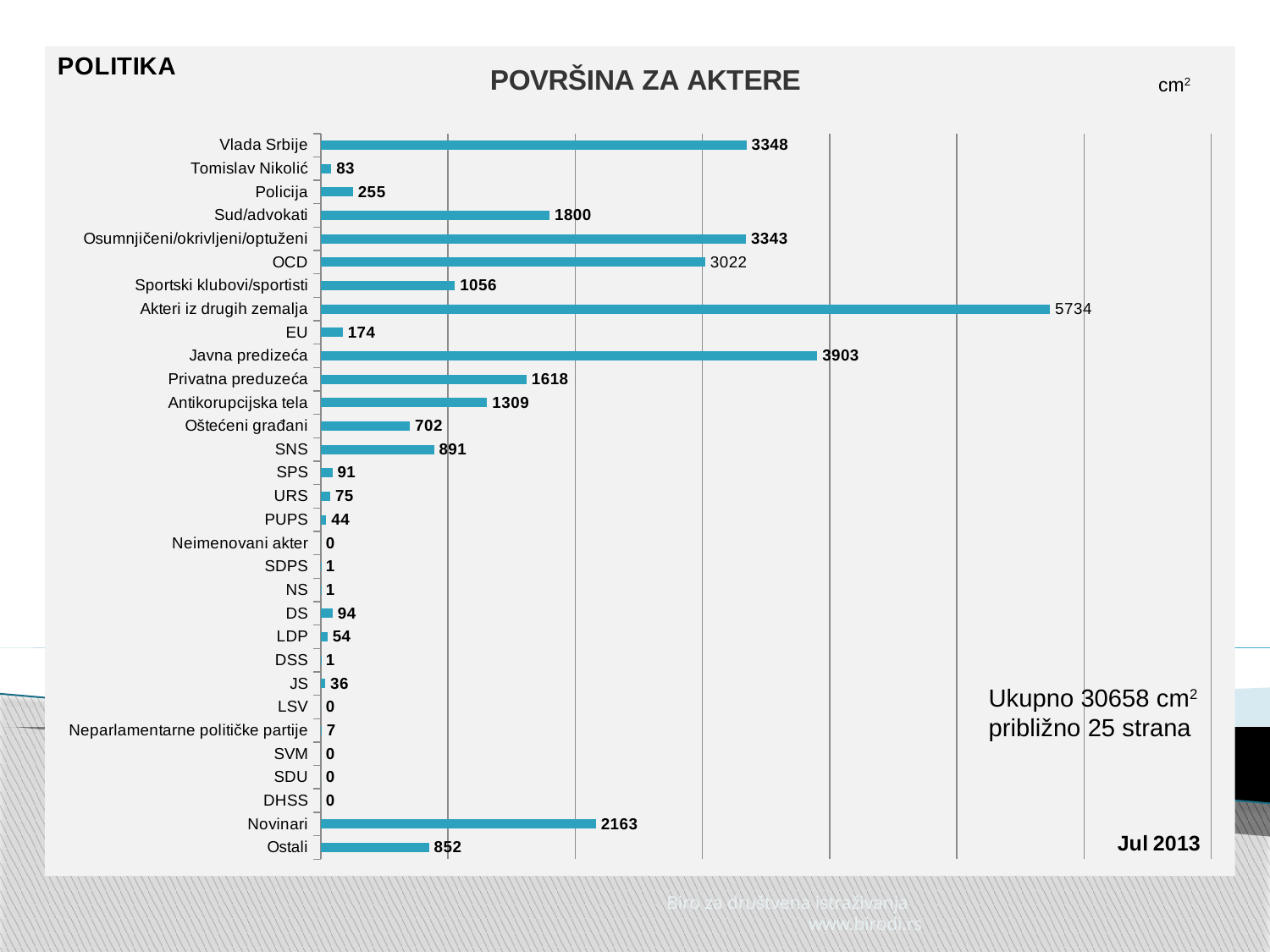
Which is larger, the value for OCD or the value for Sud/advokati? OCD What is the title of the chart? POVRŠINA ZA AKTERE What is the value for Novinari? 2163 What is the value for PUPS? 44 Which category has the highest value? Akteri iz drugih zemalja What is the value for Antikorupcijska tela? 1309 What is the difference between the values for Novinari and Ostali? 1311 What is the value for Vlada Srbije? 3348 What is the difference between the values for Javna predizeća and Privatna preduzeća? 2285 What kind of chart is shown on the slide? bar chart How many categories are shown in the chart? 31 Which is larger, the value for SNS or the value for Oštećeni građani? SNS